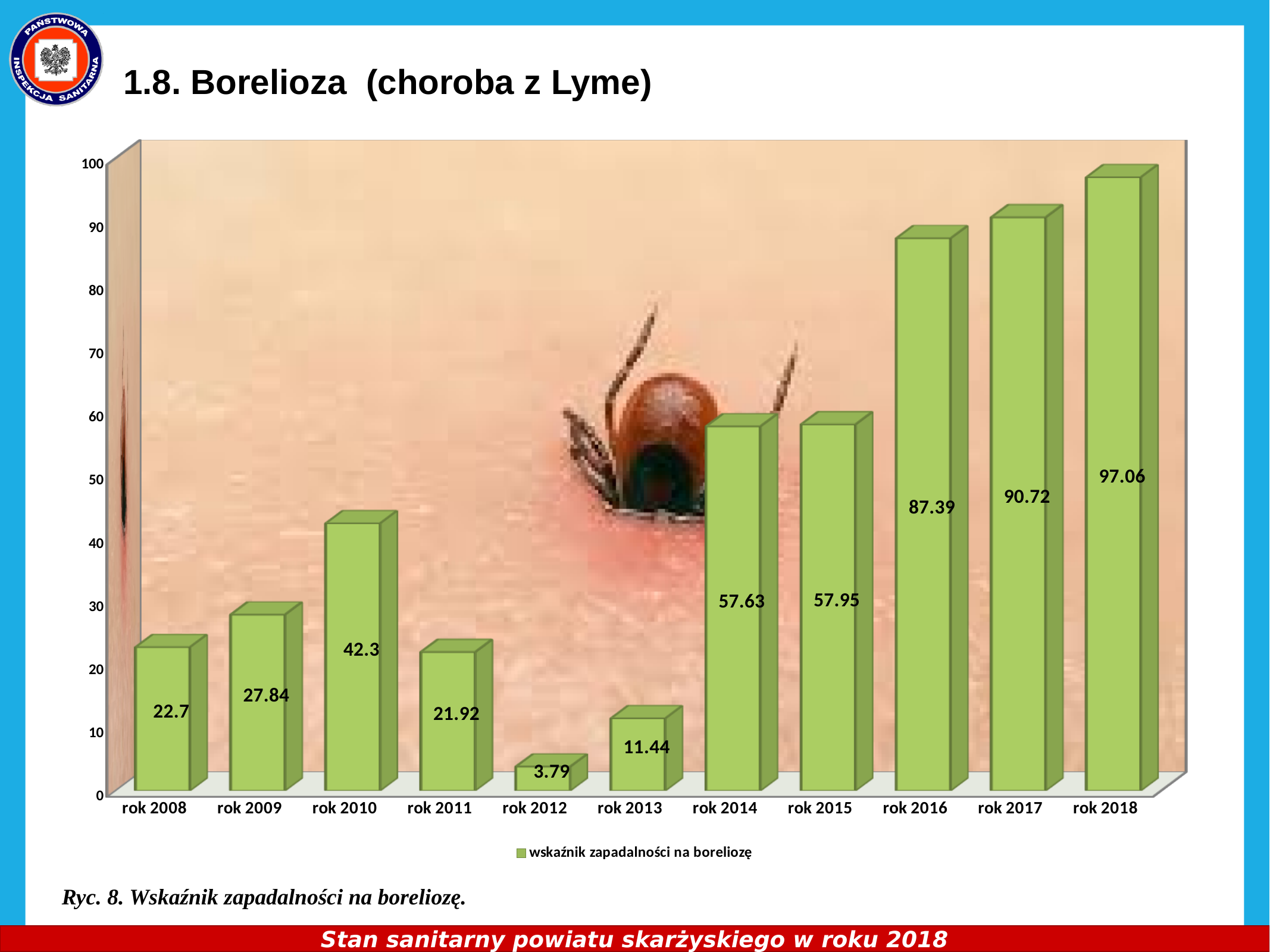
What is the legend entry for the series? wskaźnik zapadalności na boreliozę What is the value for rok 2010? 42.3 What is the difference between the values for rok 2018 and rok 2017? 6.34 Which year has the highest value? rok 2018 What is the value for rok 2016? 87.39 Is the value for rok 2014 greater or less than 50? greater Which year has the lowest value? rok 2012 What kind of chart is shown on the slide? bar chart How many years are shown on the x axis? 11 How many series does the legend list? 1 What is the value for rok 2012? 3.79 Which is larger, the value for rok 2010 or the value for rok 2011? rok 2010